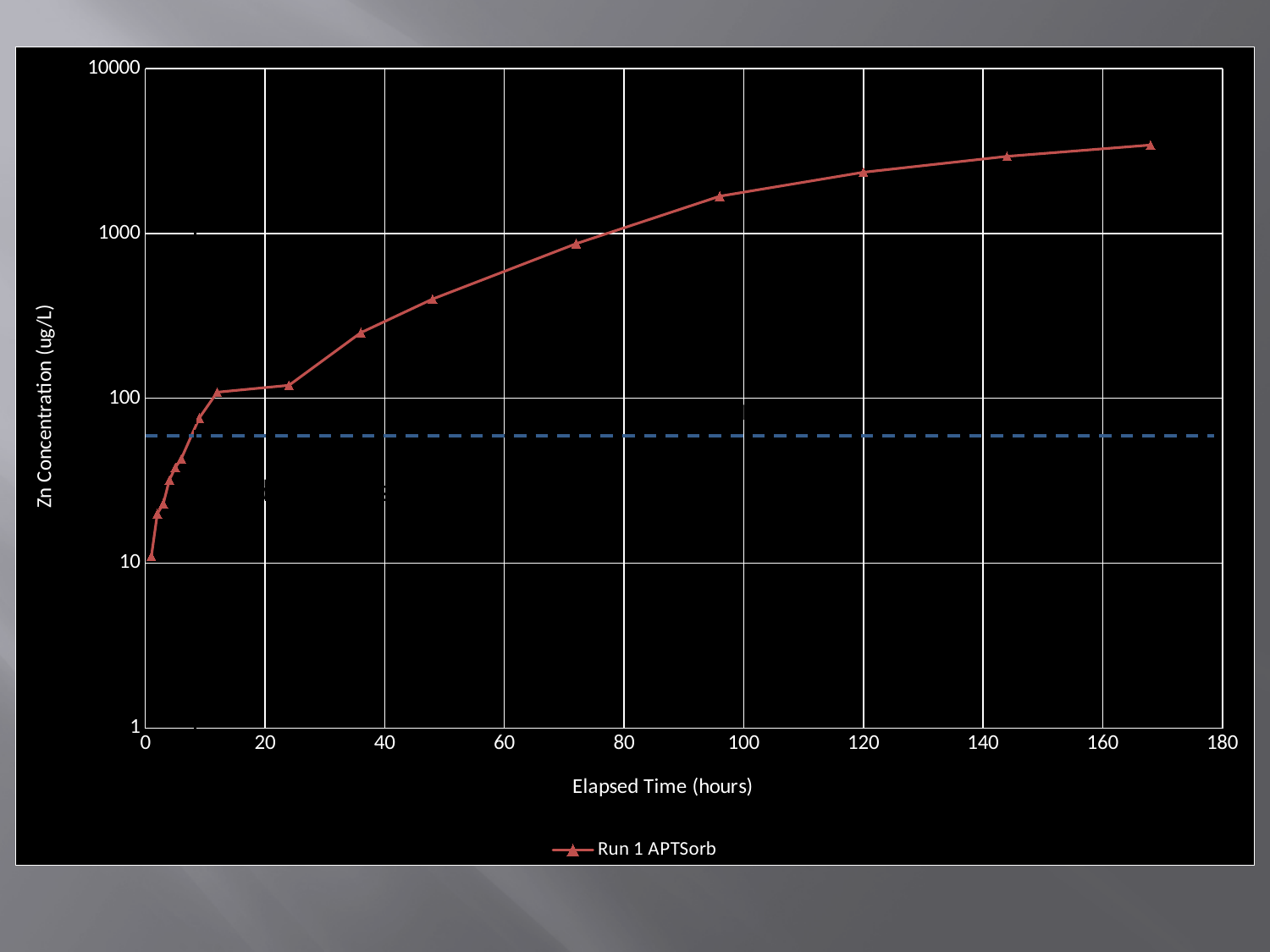
Is the Zn concentration for Run 1 APTSorb at 72 hours greater or less than 1000 ug/L? less Do the Zn concentration values rise or fall as elapsed time increases? rise Is the Zn concentration for Run 1 APTSorb at 96 hours greater or less than 1000 ug/L? greater Is the Zn concentration for Run 1 APTSorb at 36 hours greater or less than 100 ug/L? greater What is the name of the series shown in the legend? Run 1 APTSorb What kind of chart is shown on the slide? line chart At which elapsed time does Run 1 APTSorb reach its highest Zn concentration? 168 hours Which is larger for Run 1 APTSorb: the Zn concentration at 120 hours or at 48 hours? 120 hours How many series does the legend list? 1 What is the label of the y axis? Zn Concentration (ug/L)